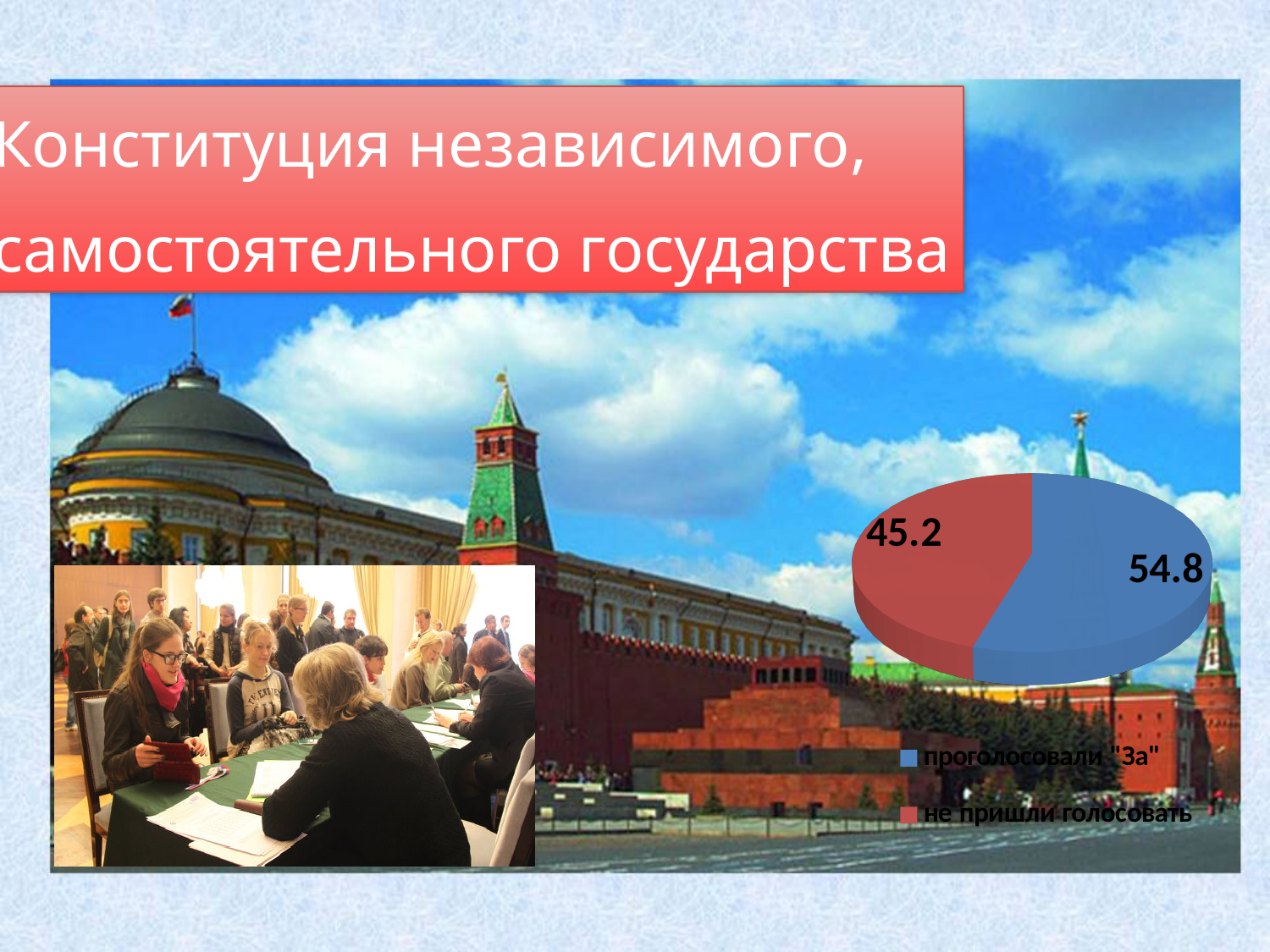
What is the difference between the values for проголосовали "За" and не пришли голосовать? 9.6 How many entries does the legend of the pie chart list? 2 What is the value for не пришли голосовать in the pie chart? 45.2 Which is larger: проголосовали "За" or не пришли голосовать? проголосовали "За" What kind of chart is shown on the slide? pie chart What is the value for проголосовали "За" in the pie chart? 54.8 Which slice of the pie chart is the largest? проголосовали "За" What colour is the slice for не пришли голосовать in the pie chart? red Which slice of the pie chart is the smallest? не пришли голосовать What colour is the slice for проголосовали "За" in the pie chart? blue How many slices does the pie chart have? 2